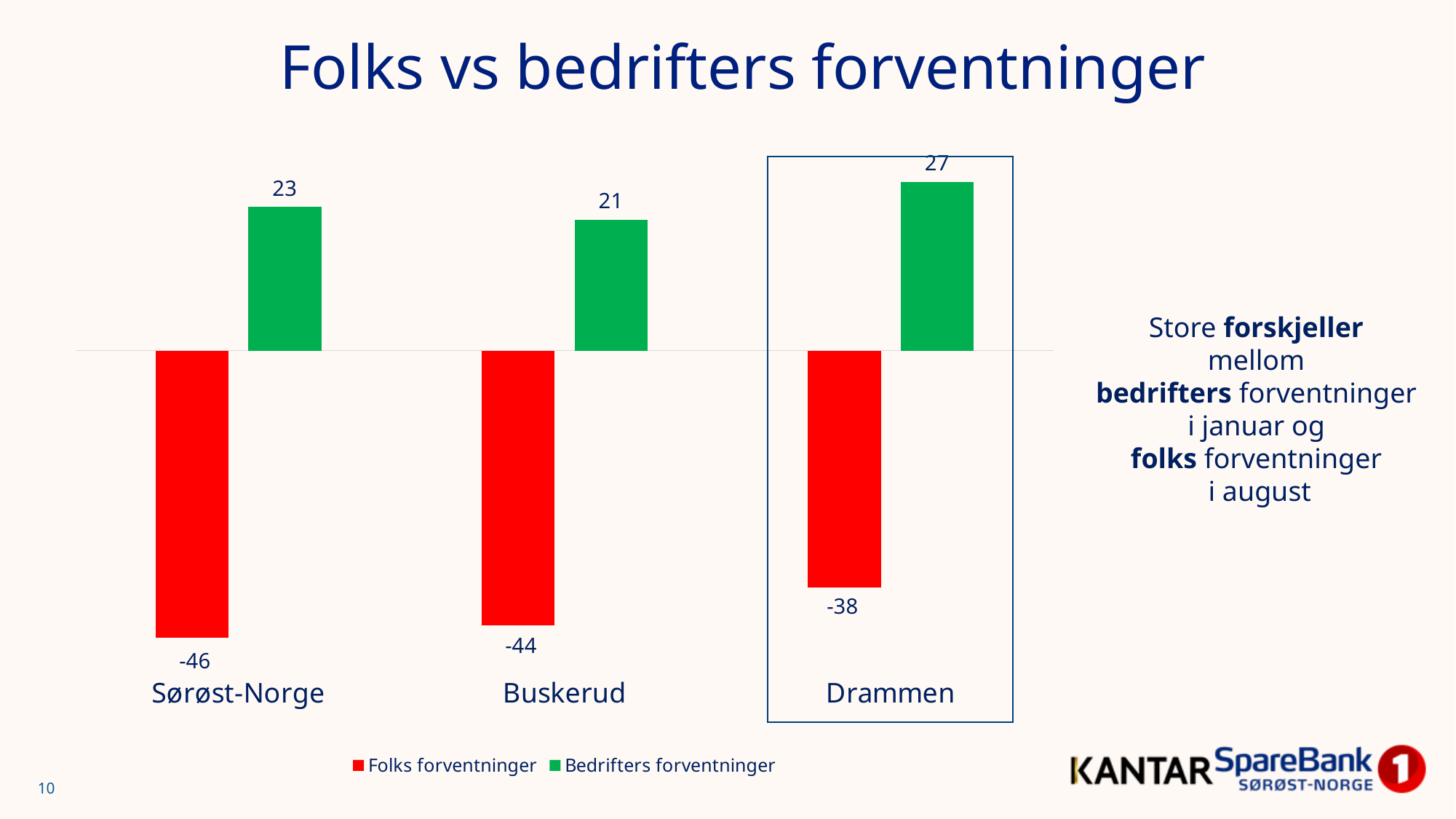
Which is larger: Bedrifters forventninger for Sørøst-Norge or for Buskerud? Sørøst-Norge Which category has the lowest value for Folks forventninger? Sørøst-Norge What is the value of Bedrifters forventninger for Buskerud? 21 What is the value of Folks forventninger for Drammen? -38 What is the value of Bedrifters forventninger for Drammen? 27 What is the difference between Bedrifters forventninger and Folks forventninger for Buskerud? 65 Which category has the highest value for Bedrifters forventninger? Drammen How many series does the legend list? 2 How many categories are shown on the x axis? 3 Which colour represents Folks forventninger in the chart? Red What kind of chart is shown on the slide? Bar chart What is the value of Folks forventninger for Sørøst-Norge? -46